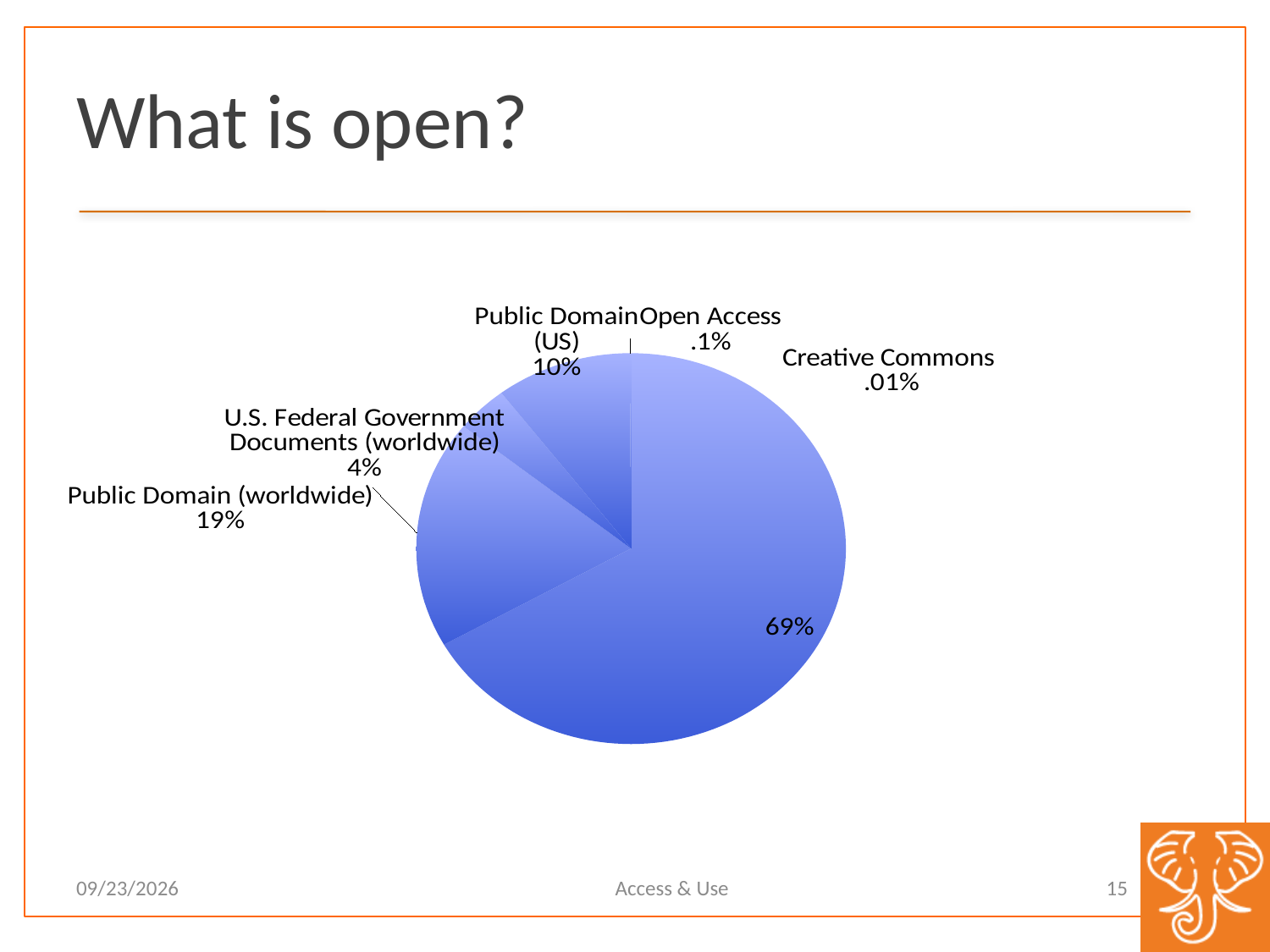
What percentage is shown for Open Access? .1% What is the largest percentage value labelled on the pie chart? 69% What kind of chart is shown on the slide? pie chart What percentage is shown for Creative Commons? .01% Which has the larger share, Public Domain (worldwide) or Public Domain (US)? Public Domain (worldwide) Which named category has the smallest share of the pie? Creative Commons Which has the larger share, Open Access or Creative Commons? Open Access What percentage is shown for U.S. Federal Government Documents (worldwide)? 4% How many percentage points larger is Public Domain (worldwide) than Public Domain (US)? 9 percentage points What percentage is shown for Public Domain (worldwide)? 19% What percentage is shown for Public Domain (US)? 10% What is the title of the slide containing the pie chart? What is open?